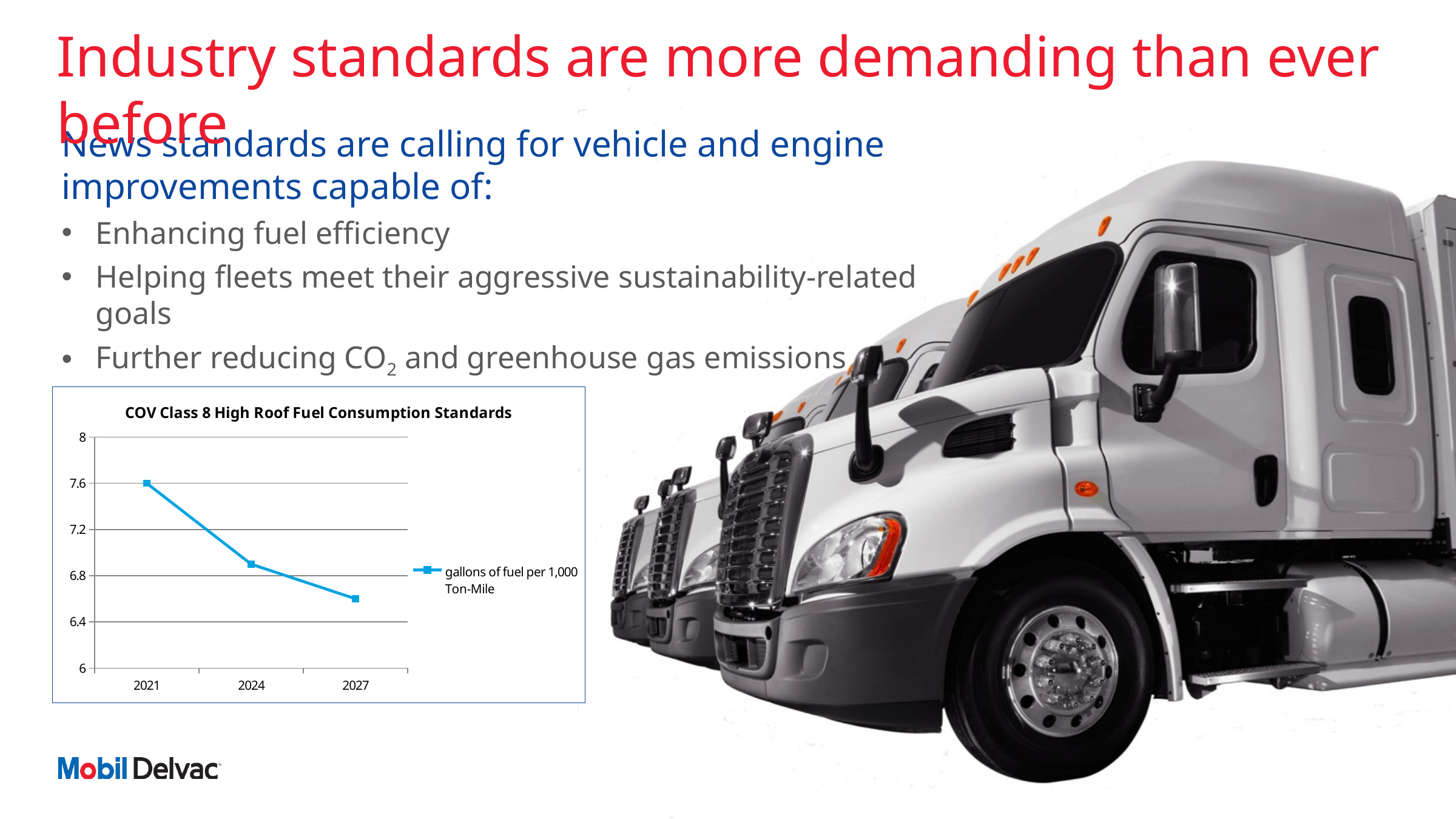
Is the value for 2027 greater or less than 6.4? greater How many series does the chart's legend list? 1 Do the values in the chart rise or fall from 2021 to 2027? fall What series name is shown in the chart's legend? gallons of fuel per 1,000 Ton-Mile Which year has the highest value in the chart? 2021 Is the value for 2024 greater or less than 7.2? less What is the title of the chart on the slide? COV Class 8 High Roof Fuel Consumption Standards What is the value for 2021 in the chart? 7.6 Which year has the larger value, 2021 or 2027? 2021 Which year has the lowest value in the chart? 2027 How many years are plotted on the x axis of the chart? 3 What kind of chart is shown on the slide? line chart